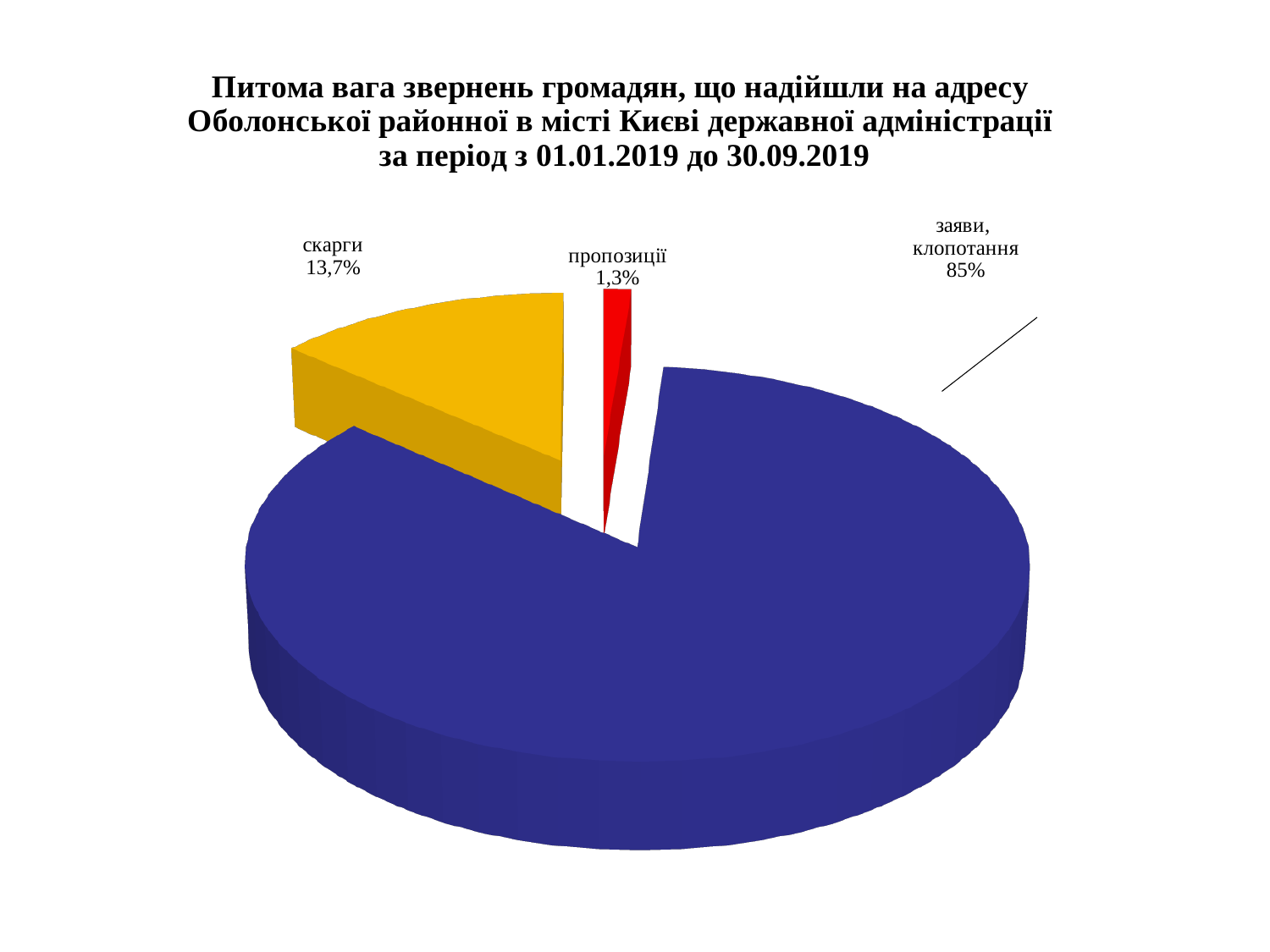
What share of the pie does the 'заяви, клопотання' slice represent? 85% Which category has the largest share of the pie? заяви, клопотання What is the difference in percentage points between the 'скарги' and 'пропозиції' slices? 12,4 Which slice is larger, 'скарги' or 'пропозиції'? скарги What kind of chart is shown on the slide? pie chart What colour is the 'скарги' slice? yellow What share of the pie does the 'скарги' slice represent? 13,7% What colour is the 'заяви, клопотання' slice? blue What share of the pie does the 'пропозиції' slice represent? 1,3% Which category has the smallest share of the pie? пропозиції What is the difference in percentage points between the 'заяви, клопотання' and 'скарги' slices? 71,3 How many categories are shown in the pie chart? 3